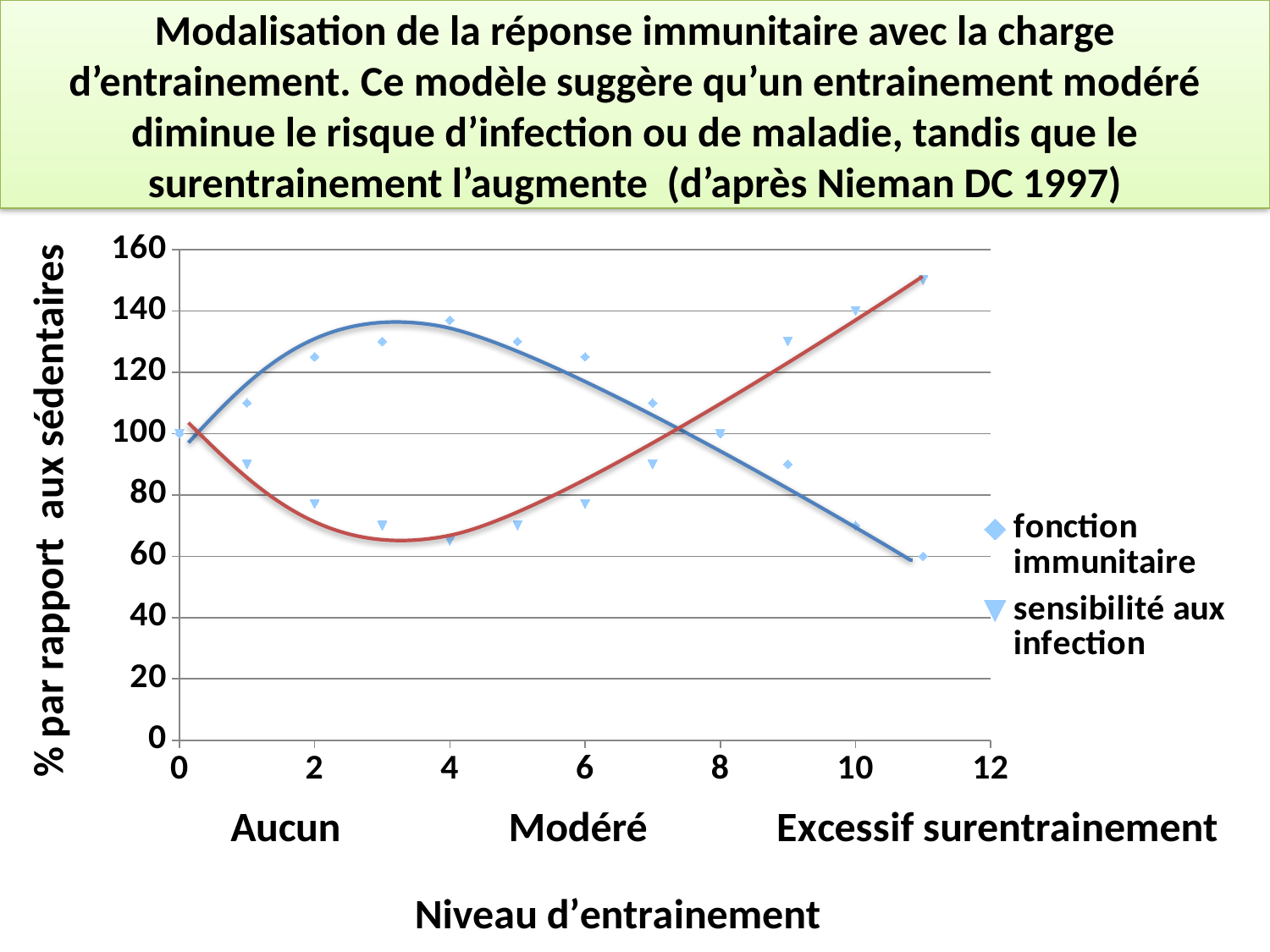
At x = 10, which series has the higher value, 'fonction immunitaire' or 'sensibilité aux infection'? sensibilité aux infection Does 'fonction immunitaire' rise or fall between x = 4 and x = 11? fall Is the value of 'sensibilité aux infection' at x = 4 greater or less than 80? less How many series does the legend list? 2 Is the value of 'fonction immunitaire' at x = 4 greater or less than 120? greater What is the value of 'fonction immunitaire' at x = 0? 100 What kind of chart is shown on the slide? scatter chart At which x value does 'sensibilité aux infection' reach its highest point? 11 What is the title of the x axis? Niveau d'entrainement What are the two series named in the legend? fonction immunitaire; sensibilité aux infection What is the value of 'fonction immunitaire' at x = 11? 60 How many data points are plotted for the 'fonction immunitaire' series? 12